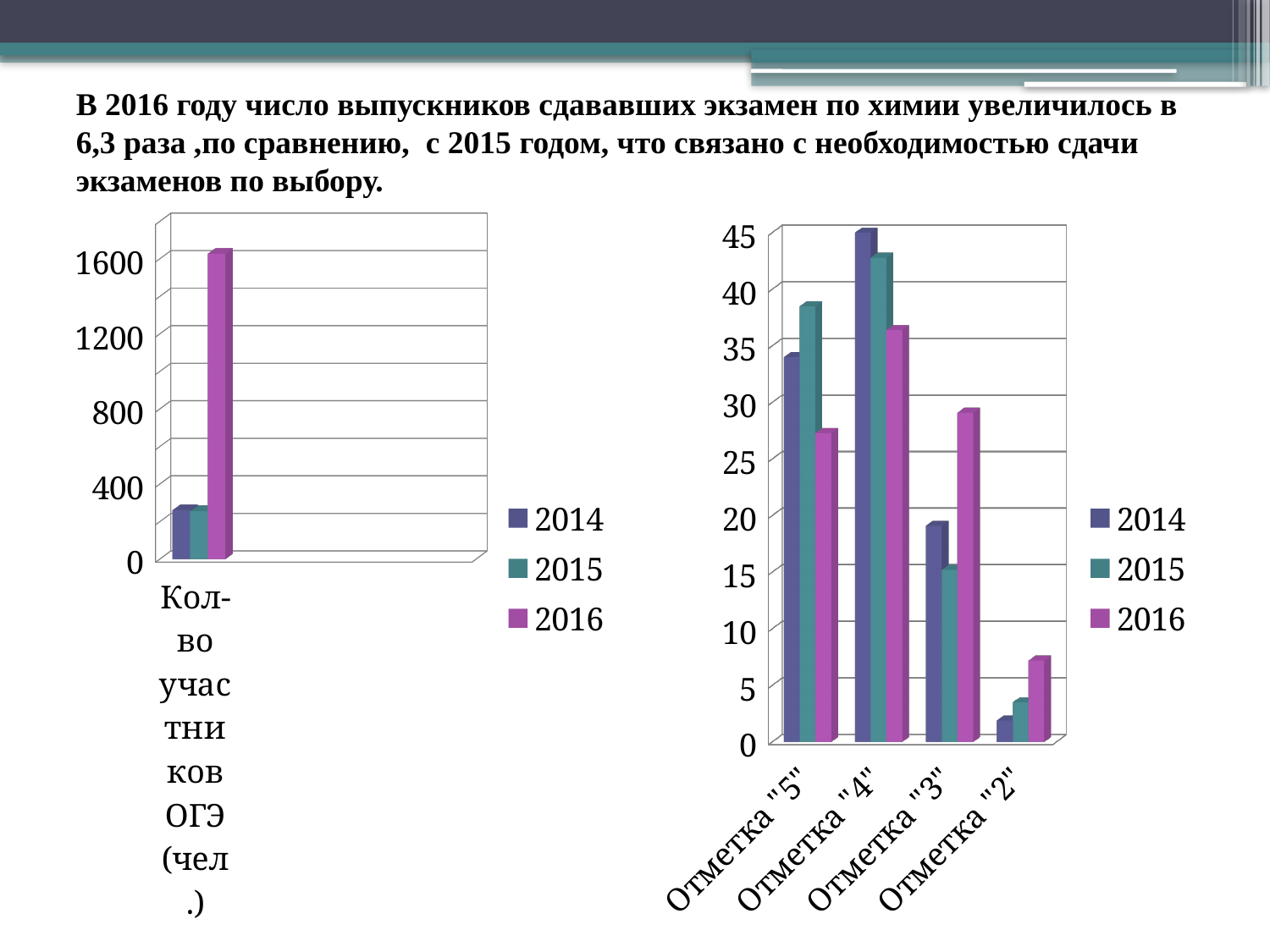
In the right chart, for Отметка "5", which is larger: the 2014 value or the 2016 value? 2014 In the left chart (Кол-во участников ОГЭ), which year has the highest value? 2016 In the right chart, which series has the highest value for Отметка "4"? 2014 How many series does the legend of the left chart list? 3 In the left chart, is the value for 2014 greater or less than 400? less In the left chart, is the value for 2016 greater or less than 1200? greater In the right chart, is the 2015 value for Отметка "5" greater or less than 35? greater What kind of chart is the left chart (Кол-во участников ОГЭ)? bar chart How many categories are shown on the x axis of the right chart? 4 In the right chart, which series has the lowest value for Отметка "2"? 2014